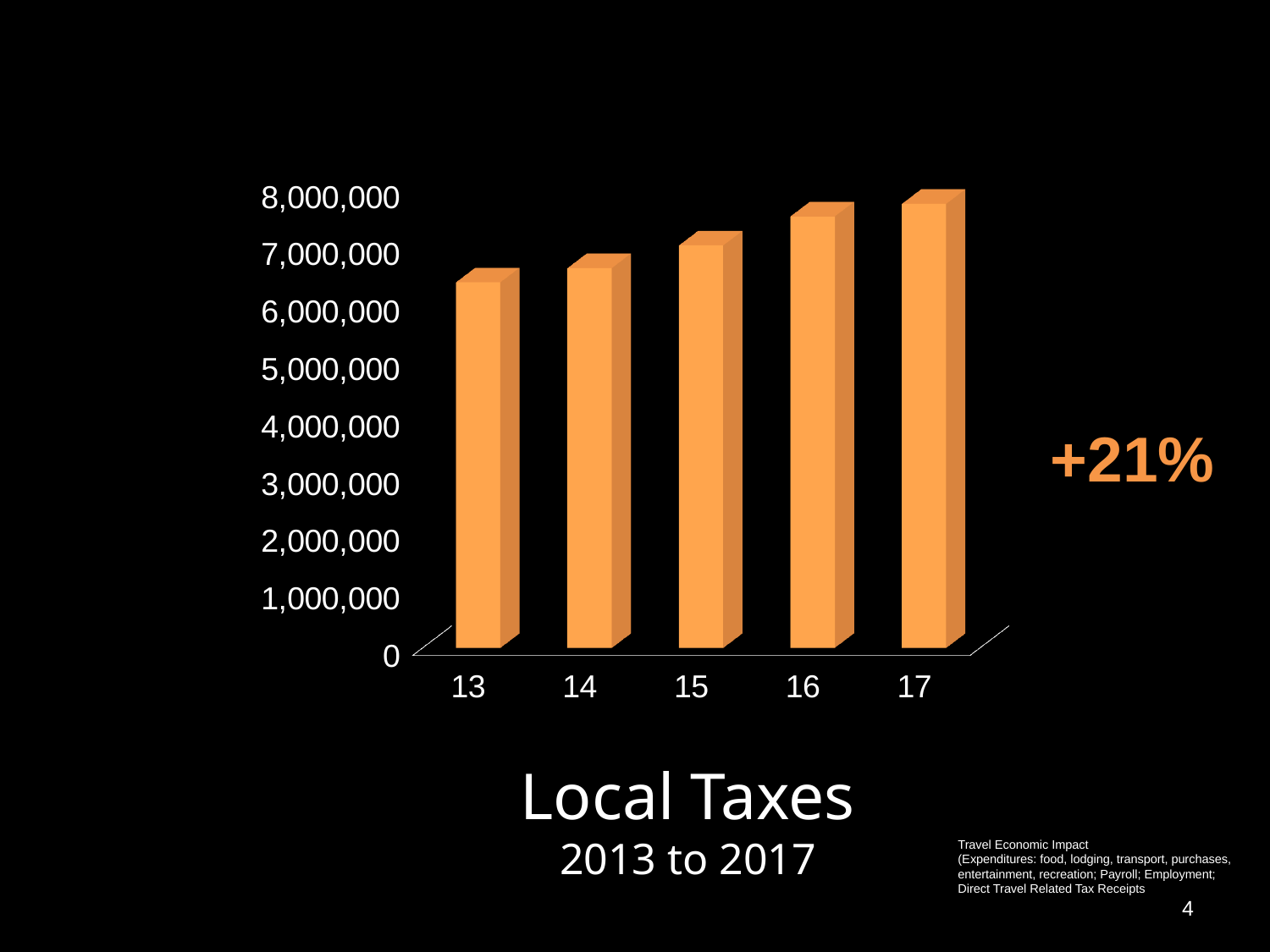
What is the title of the chart? Local Taxes 2013 to 2017 How many bars (years) are plotted in the chart? 5 What percentage change is annotated next to the chart? +21% Which is larger, the value for 16 or the value for 13? 16 Do the values rise or fall from 13 to 17 along the x axis? rise Is the value for 14 greater or less than 7,000,000? less Is the value for 16 greater or less than 7,000,000? greater What kind of chart is shown on the slide? bar chart Is the value for 13 greater or less than 6,000,000? greater Which year has the lowest local taxes value? 13 Which year has the highest local taxes value? 17